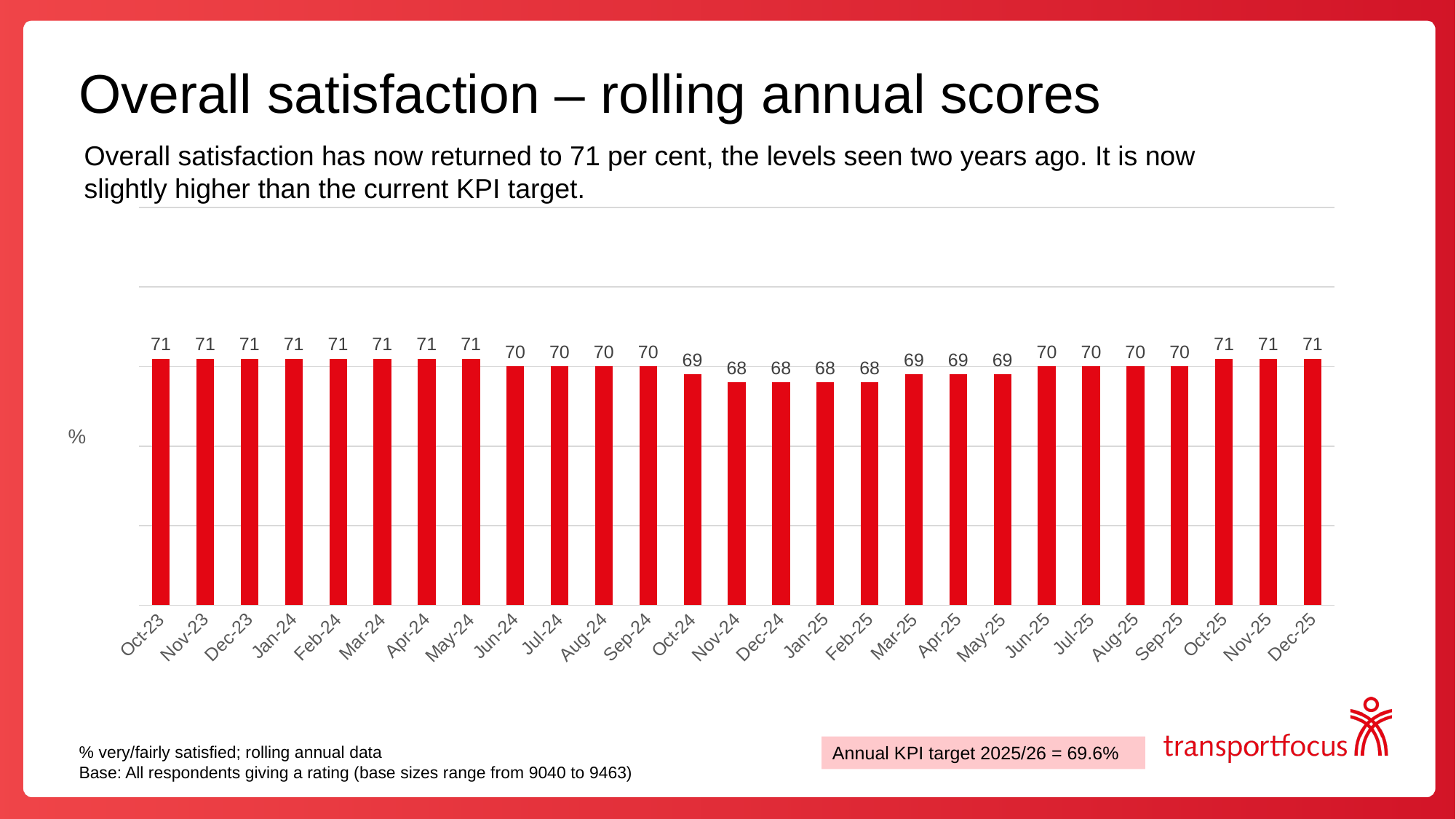
What is the lowest value shown on the chart? 68 What kind of chart is shown on the slide? Bar chart What is the value for Jan-25? 68 What is the value for Jun-25? 70 Which months have the lowest value on the chart? Nov-24, Dec-24, Jan-25, Feb-25 What is the difference between the values for Oct-23 and Jan-25? 3 What is the annual KPI target for 2025/26 stated on the slide? 69.6% What is the value for Dec-25? 71 Do the values rise or fall from Oct-23 to Feb-25? Fall Which is larger, the value for May-24 or the value for Nov-24? May-24 What is the value for Oct-23? 71 How many months are shown on the x axis? 27